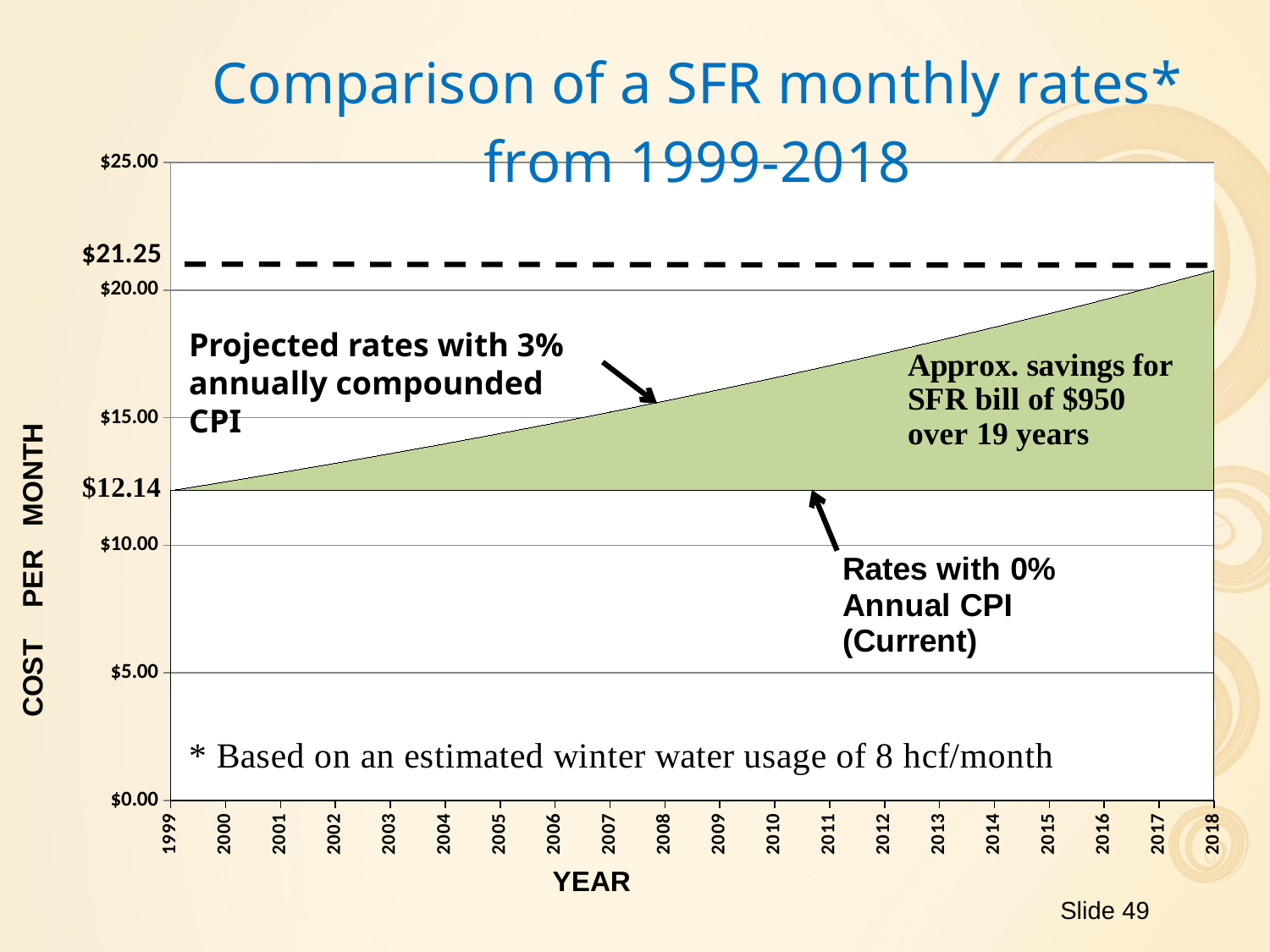
Is the projected rate with 3% annually compounded CPI in 2018 greater or less than $20.00? greater In which year is the projected rate with 3% annually compounded CPI highest? 2018 Is the projected rate with 3% annually compounded CPI in 2005 greater or less than $15.00? less What is the monthly rate with 0% annual CPI (current) in 2018? $12.14 What is the monthly rate with 0% annual CPI (current) in 1999? $12.14 What is the title of the x axis? YEAR Do the projected rates with 3% annually compounded CPI rise or fall from 1999 to 2018? rise According to the annotation, what is the approximate savings for a SFR bill over 19 years? $950 What kind of chart is shown on the slide? area chart In 2018, which is larger: the projected rate with 3% CPI or the rate with 0% annual CPI? projected rate with 3% CPI What value does the dashed horizontal reference line mark on the y axis? $21.25 How many years are shown along the x axis? 20